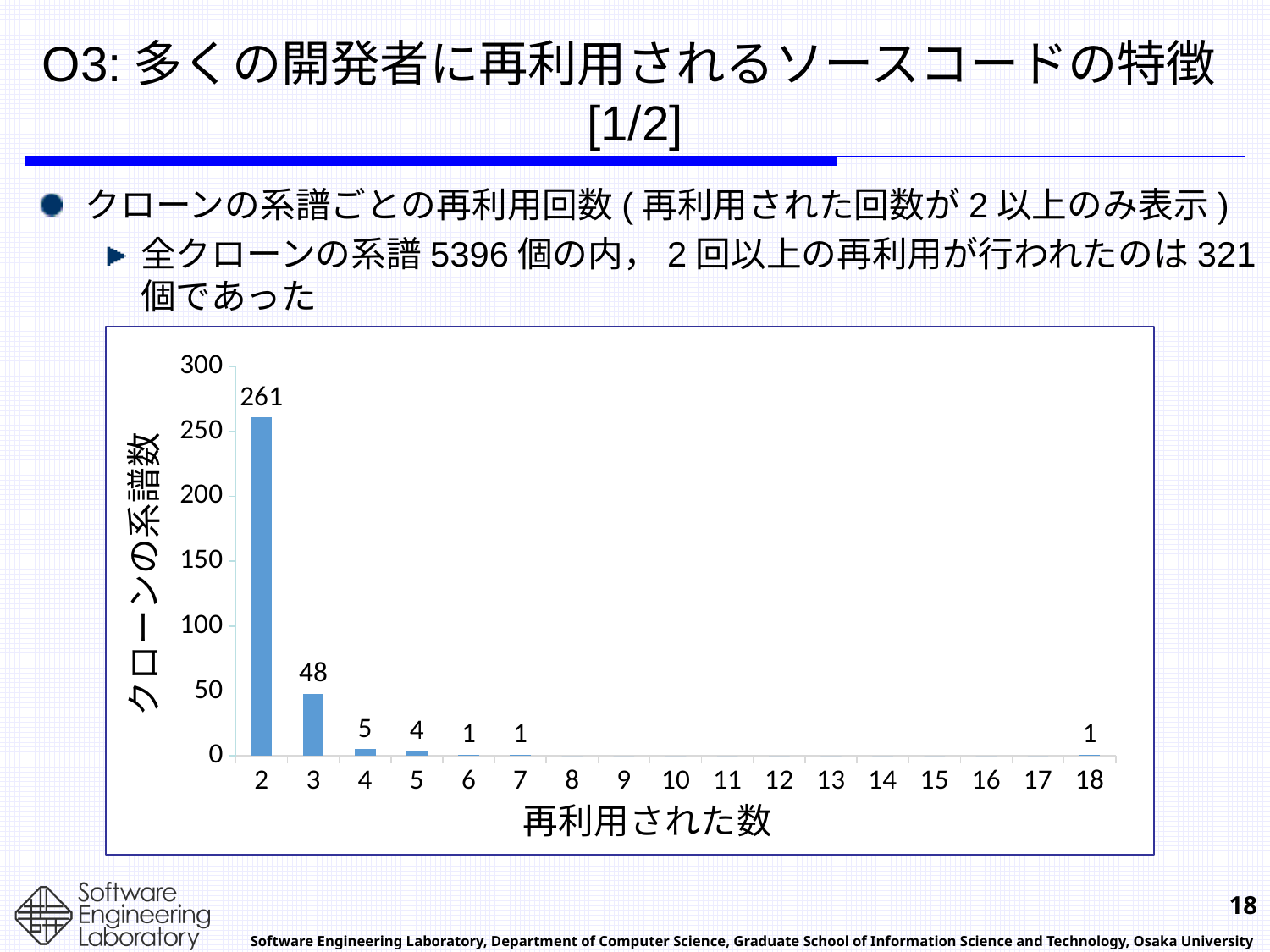
What is the difference between the number of clone genealogies for reuse count 2 and reuse count 3? 213 What is the number of clone genealogies for a reuse count of 18? 1 Which has more clone genealogies: reuse count 4 or reuse count 5? 4 What is the number of clone genealogies for a reuse count of 3? 48 How many reuse-count categories are shown on the x axis? 17 What is the title of the x axis of the chart? 再利用された数 Which reuse count on the x axis has the highest number of clone genealogies? 2 What is the title of the y axis of the chart? クローンの系譜数 What is the number of clone genealogies for a reuse count of 4? 5 What is the number of clone genealogies (クローンの系譜数) for a reuse count (再利用された数) of 2? 261 Is the number of clone genealogies for reuse count 2 greater or less than 250? greater What kind of chart is shown on the slide? bar chart